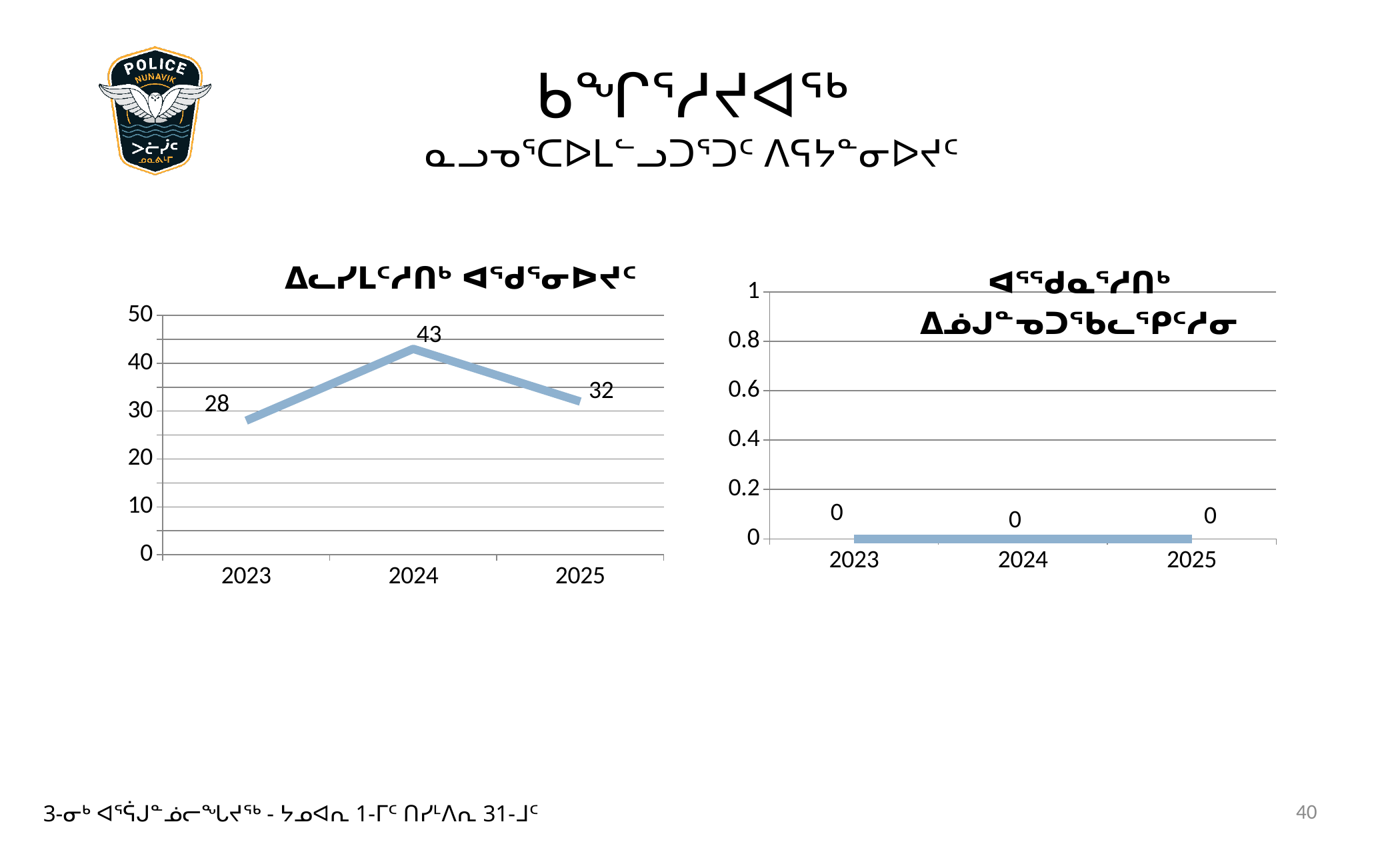
What kind of chart is the left chart? line chart In the left chart, what is the value for 2023? 28 In the left chart, what is the difference between the values for 2024 and 2023? 15 In the right chart, what is the total of the values for 2023, 2024 and 2025? 0 In the right chart, what is the value for 2024? 0 In the left chart, is the value for 2024 greater or less than 40? greater In the left chart, what is the value for 2024? 43 In the left chart, what is the value for 2025? 32 In the left chart, which is larger, the value for 2025 or the value for 2023? 2025 How many years are plotted in the left chart? 3 In the left chart, which year has the highest value? 2024 In the left chart, which year has the lowest value? 2023